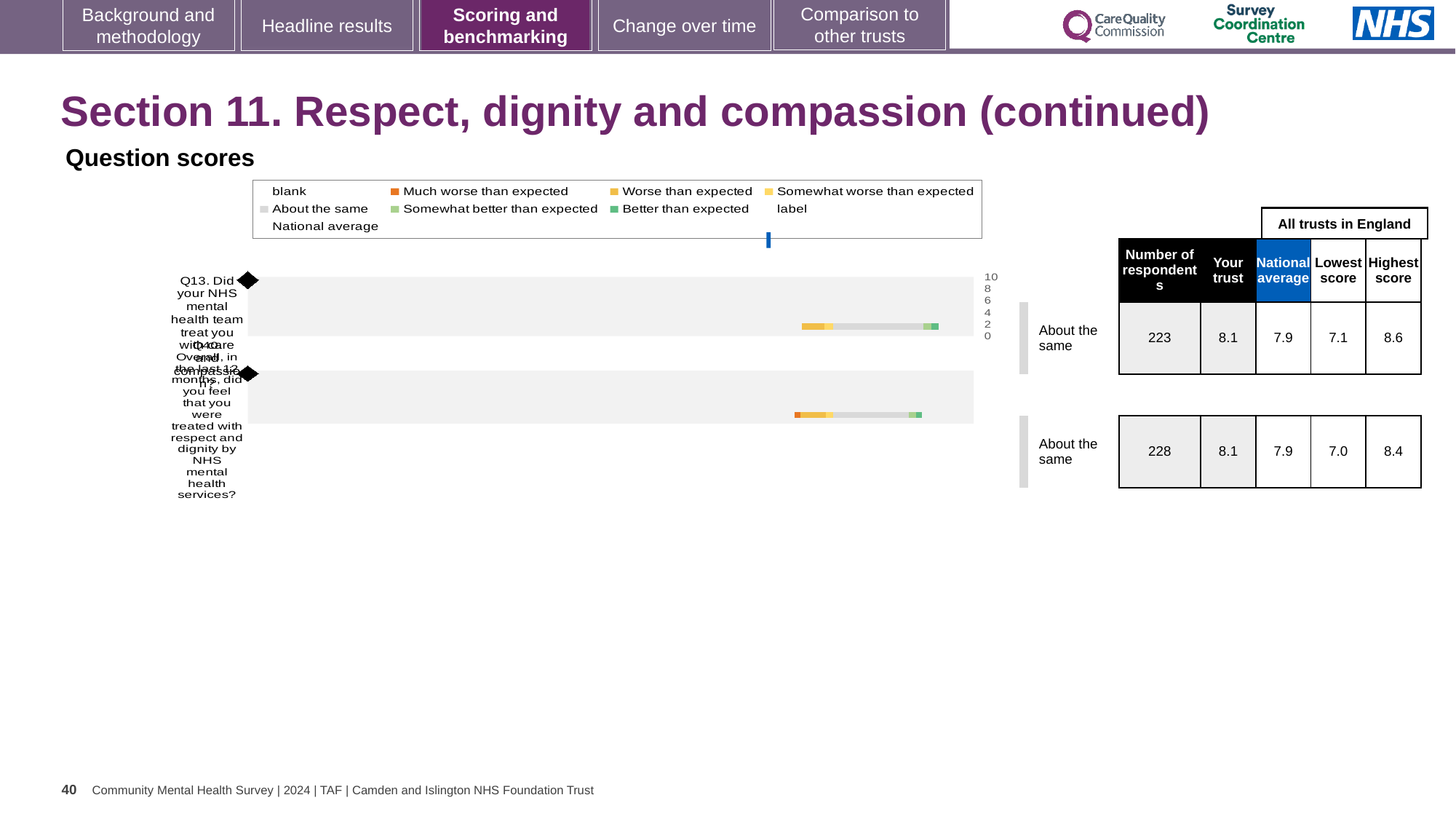
What is the lowest score among all trusts in England for Q40 (respect and dignity)? 7.0 What is the difference between the highest and lowest scores across all trusts for Q40? 1.4 What benchmark category is shown next to the Q13 bar? About the same What is the national average score for Q13? 7.9 How many survey questions are plotted in the chart? 2 What kind of chart is shown under 'Question scores'? bar chart What is the highest score among all trusts in England for Q40? 8.4 What is the number of respondents for Q40? 228 What is the number of respondents for Q13 (care and compassion)? 223 What is the 'Your trust' score for Q13? 8.1 Which question has the higher 'Highest score' across all trusts in England, Q13 or Q40? Q13 By how much does the 'Your trust' score for Q13 exceed the national average for Q13? 0.2